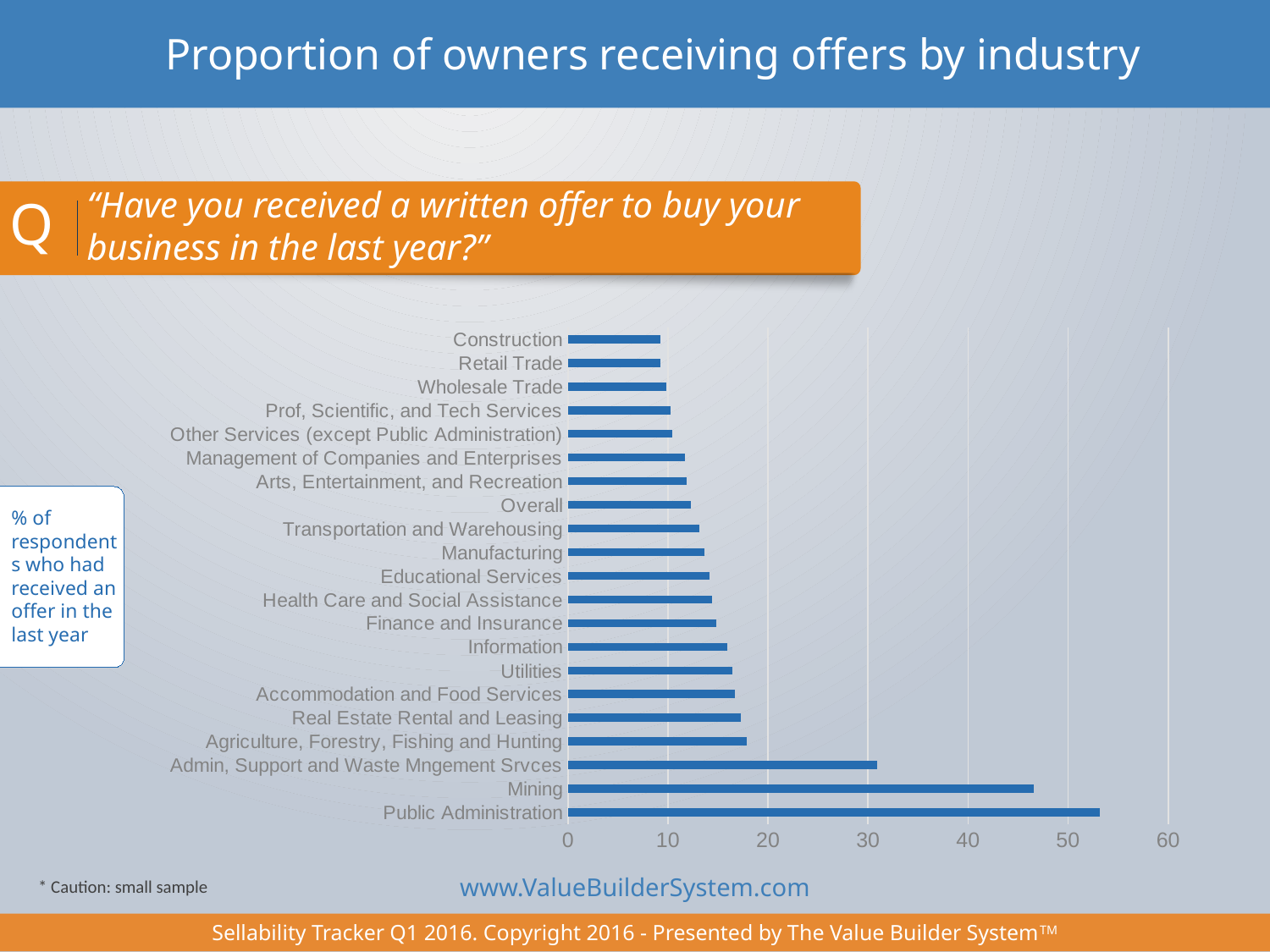
Is the value for Public Administration greater or less than 50? greater Is the value for Mining greater or less than 40? greater How many categories (bars) are plotted in the chart? 21 Which industry has the highest proportion of owners receiving offers? Public Administration What is the title of the chart on the slide? Proportion of owners receiving offers by industry Is the value for Agriculture, Forestry, Fishing and Hunting greater or less than 20? less What kind of chart is shown on the slide? Bar chart Which is larger, the value for Mining or the value for Admin, Support and Waste Mngement Srvces? Mining Which is larger, the value for Agriculture, Forestry, Fishing and Hunting or the value for Construction? Agriculture, Forestry, Fishing and Hunting